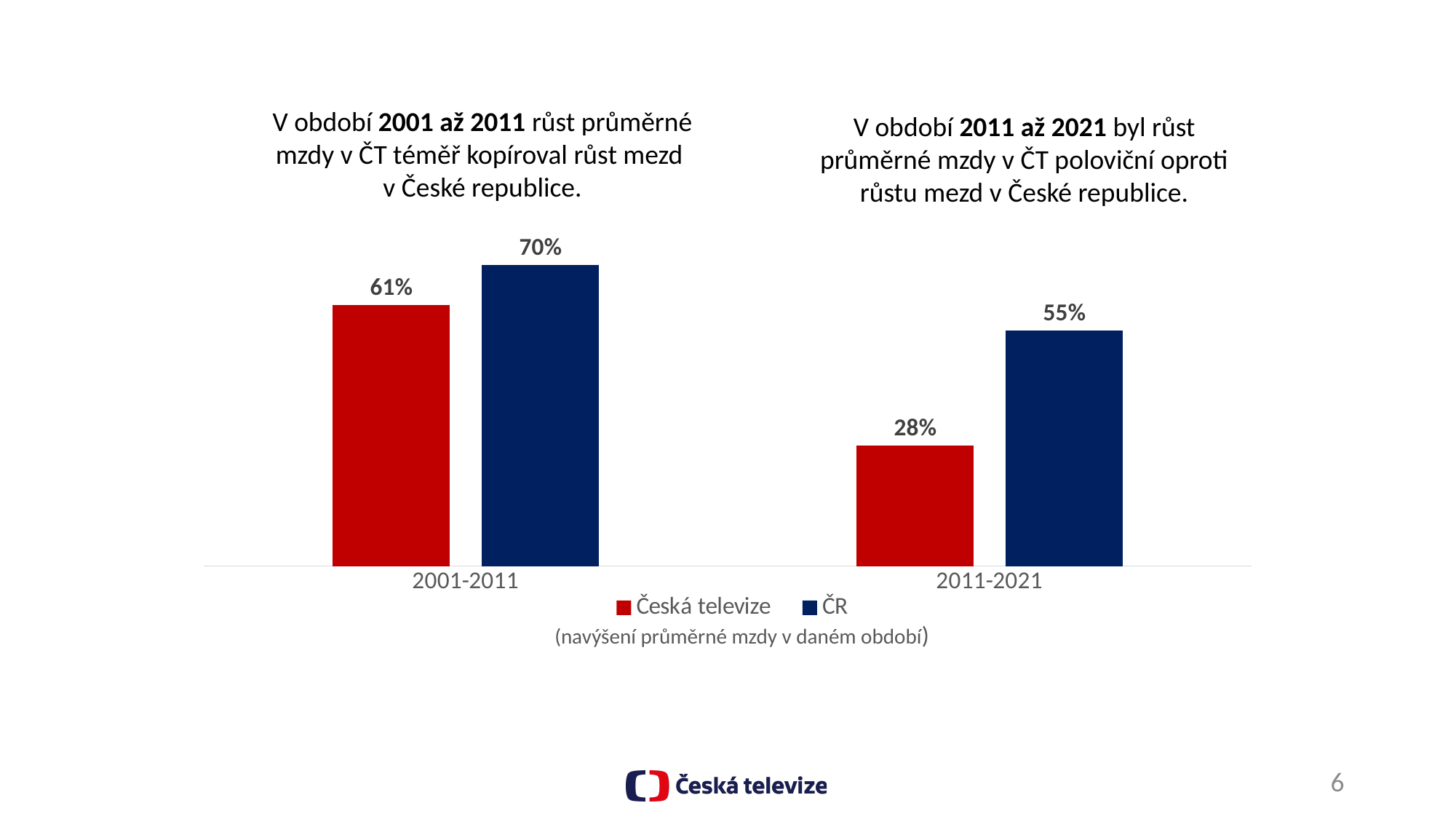
What is the value for ČR in the 2001-2011 period? 70% What is the value for Česká televize in the 2001-2011 period? 61% What is the difference between the ČR and Česká televize values in the 2011-2021 period? 27% What is the value for ČR in the 2011-2021 period? 55% How many periods are shown on the x axis? 2 Which bar has the highest value on the chart? ČR, 2001-2011 Which is larger in the 2011-2021 period, Česká televize or ČR? ČR How many series does the legend list? 2 What is the difference between the ČR and Česká televize values in the 2001-2011 period? 9% Which bar has the lowest value on the chart? Česká televize, 2011-2021 What is the value for Česká televize in the 2011-2021 period? 28% What kind of chart is shown on the slide? Bar chart